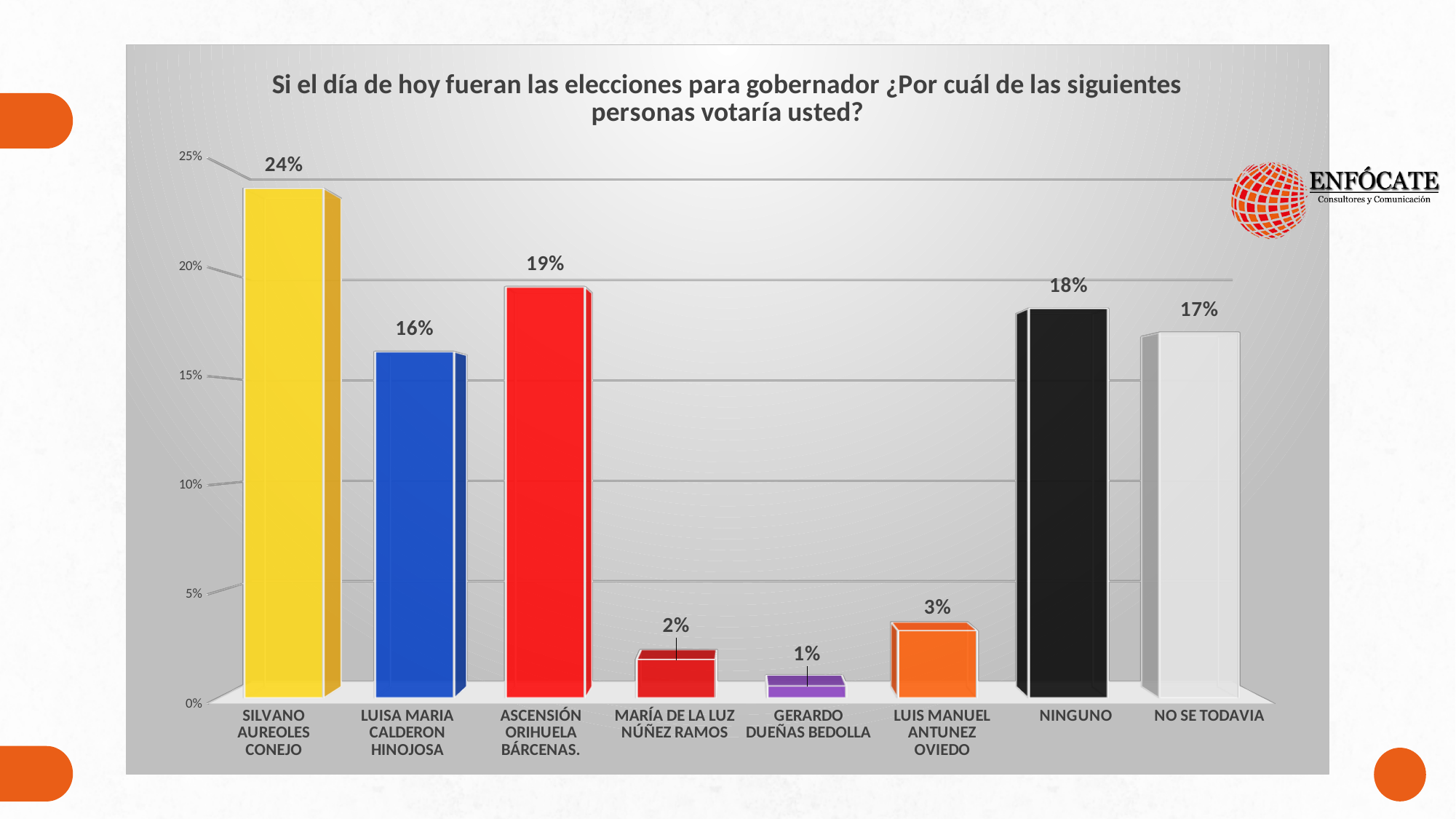
Which category has the lowest value in the chart? Gerardo Dueñas Bedolla What colour is the bar for Ascensión Orihuela Bárcenas? Red Which category has the highest value in the chart? Silvano Aureoles Conejo Which is larger, the value for Ninguno or the value for No Se Todavia? Ninguno What kind of chart is shown on the slide? Bar chart How many categories are shown on the x axis of the chart? 8 What percentage is shown for the 'Ninguno' category? 18% What is the value for Gerardo Dueñas Bedolla? 1% What percentage of respondents said they would vote for Silvano Aureoles Conejo? 24% What is the value shown for Ascensión Orihuela Bárcenas? 19% Is the value for Luis Manuel Antunez Oviedo greater or less than 5%? less What is the difference between the values for Silvano Aureoles Conejo and Luisa Maria Calderon Hinojosa? 8%